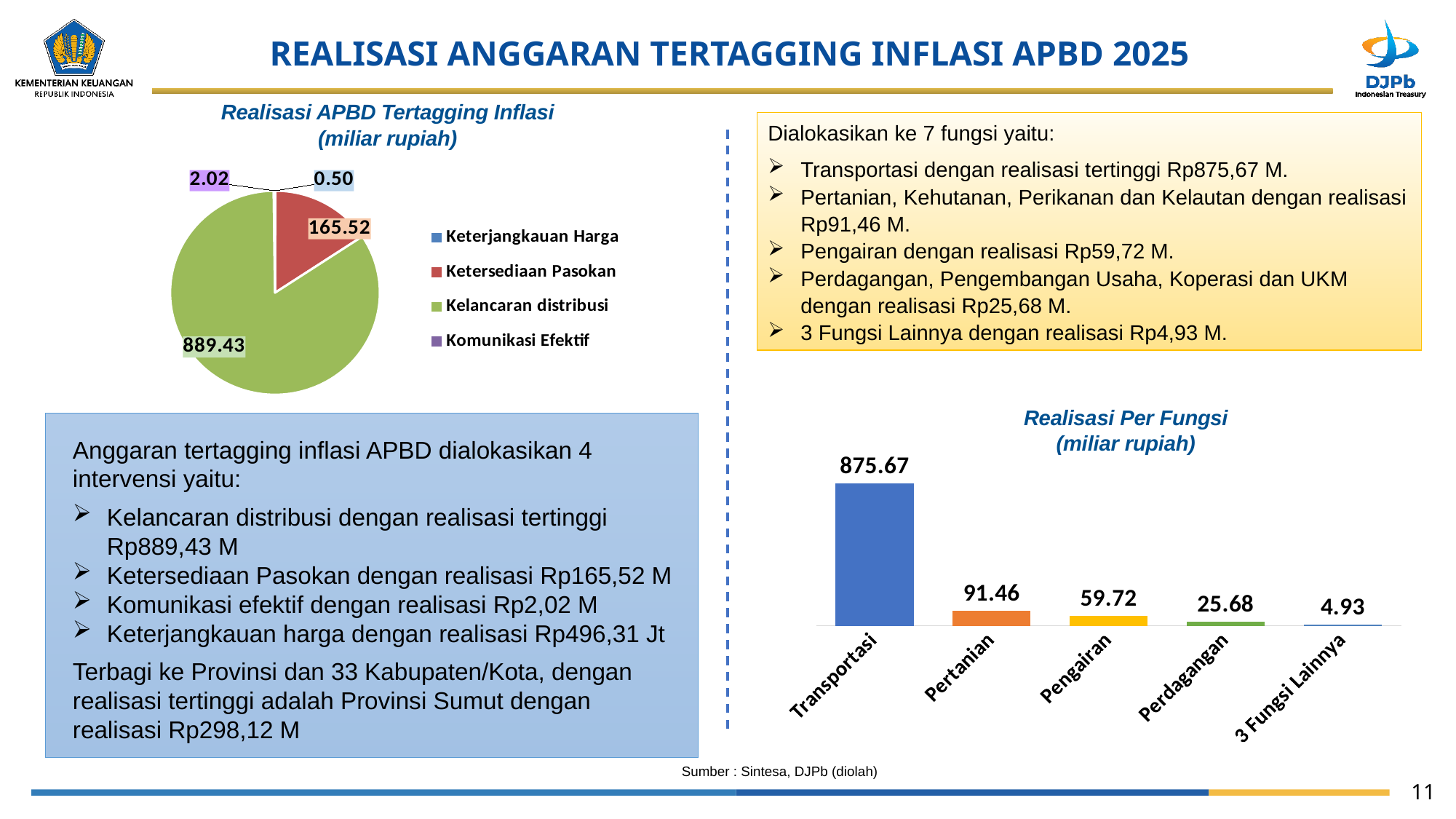
What type of chart is 'Realisasi Per Fungsi'? Bar chart In the 'Realisasi Per Fungsi' chart, what is the value for Transportasi? 875.67 In the 'Realisasi APBD Tertagging Inflasi' pie chart, what is the value for Ketersediaan Pasokan? 165.52 In the 'Realisasi Per Fungsi' chart, what is the value for Pengairan? 59.72 In the 'Realisasi APBD Tertagging Inflasi' pie chart, how many categories does the legend list? 4 In the 'Realisasi APBD Tertagging Inflasi' pie chart, what is the value for Kelancaran distribusi? 889.43 In the 'Realisasi Per Fungsi' chart, which category has the lowest value? 3 Fungsi Lainnya In the 'Realisasi APBD Tertagging Inflasi' pie chart, what is the difference between Ketersediaan Pasokan and Komunikasi Efektif? 163.50 What type of chart is 'Realisasi APBD Tertagging Inflasi'? Pie chart In the 'Realisasi Per Fungsi' chart, which is larger, Pertanian or Perdagangan? Pertanian In the 'Realisasi APBD Tertagging Inflasi' pie chart, which category has the smallest slice? Keterjangkauan Harga In the 'Realisasi Per Fungsi' chart, what is the difference between Transportasi and Pertanian? 784.21